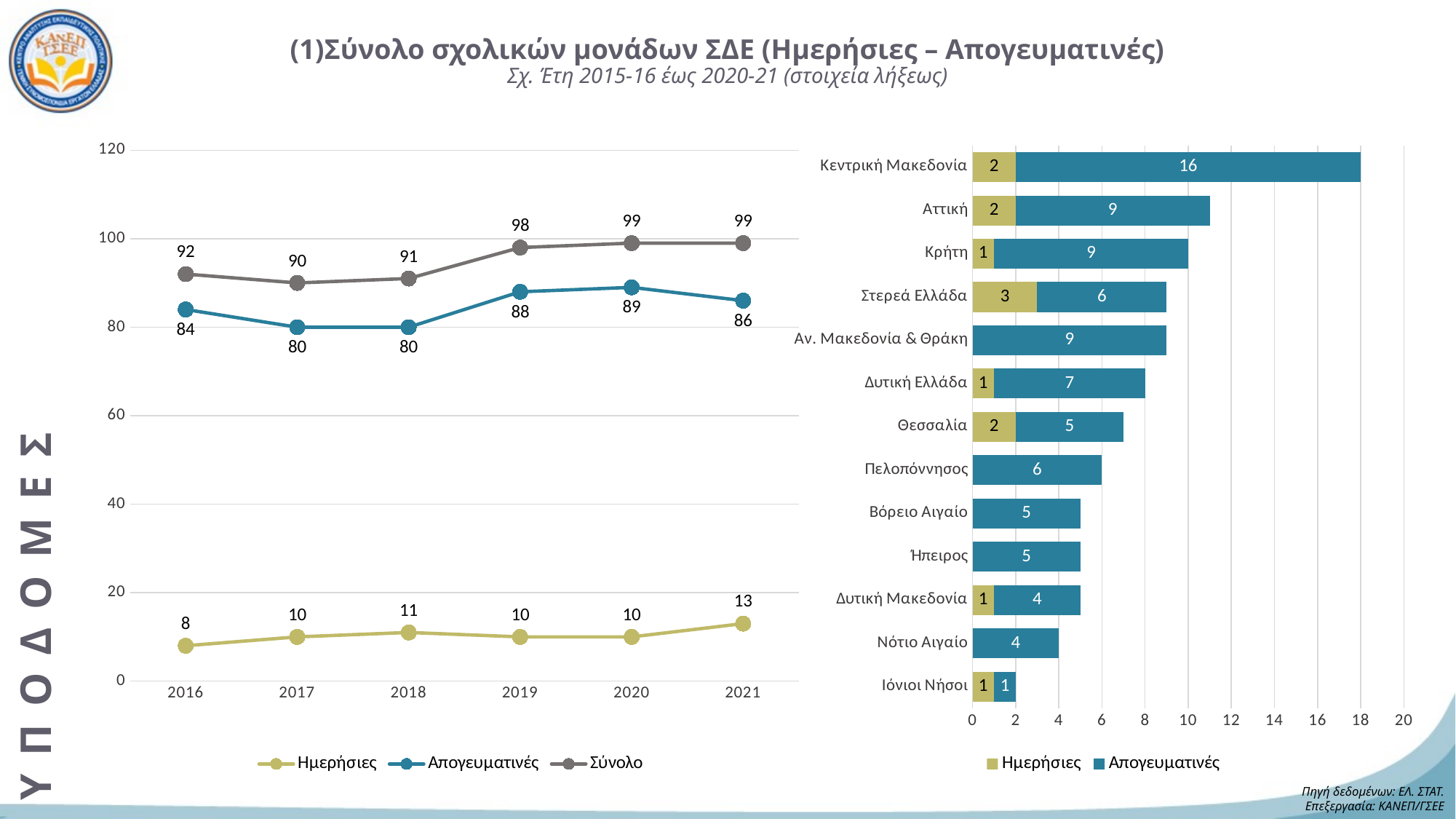
In the line chart on the left, does the Σύνολο series rise or fall from 2018 to 2019? rise In the bar chart on the right, what is the total of the stacked bar for Στερεά Ελλάδα? 9 What kind of chart is shown on the right side of the slide? bar chart In the line chart on the left, how many series does the legend list? 3 In the bar chart on the right, how many regions are shown? 13 In the line chart on the left, what is the difference between the Σύνολο values for 2021 and 2016? 7 In the line chart on the left, which year has the highest value for Ημερήσιες? 2021 In the bar chart on the right, which is larger: the Απογευματινές value for Αττική or for Θεσσαλία? Αττική In the bar chart on the right, which region has the lowest total? Ιόνιοι Νήσοι In the bar chart on the right, what is the Απογευματινές value for Κεντρική Μακεδονία? 16 In the line chart on the left, what is the value of Σύνολο in 2019? 98 In the line chart on the left, what is the value of Απογευματινές in 2021? 86